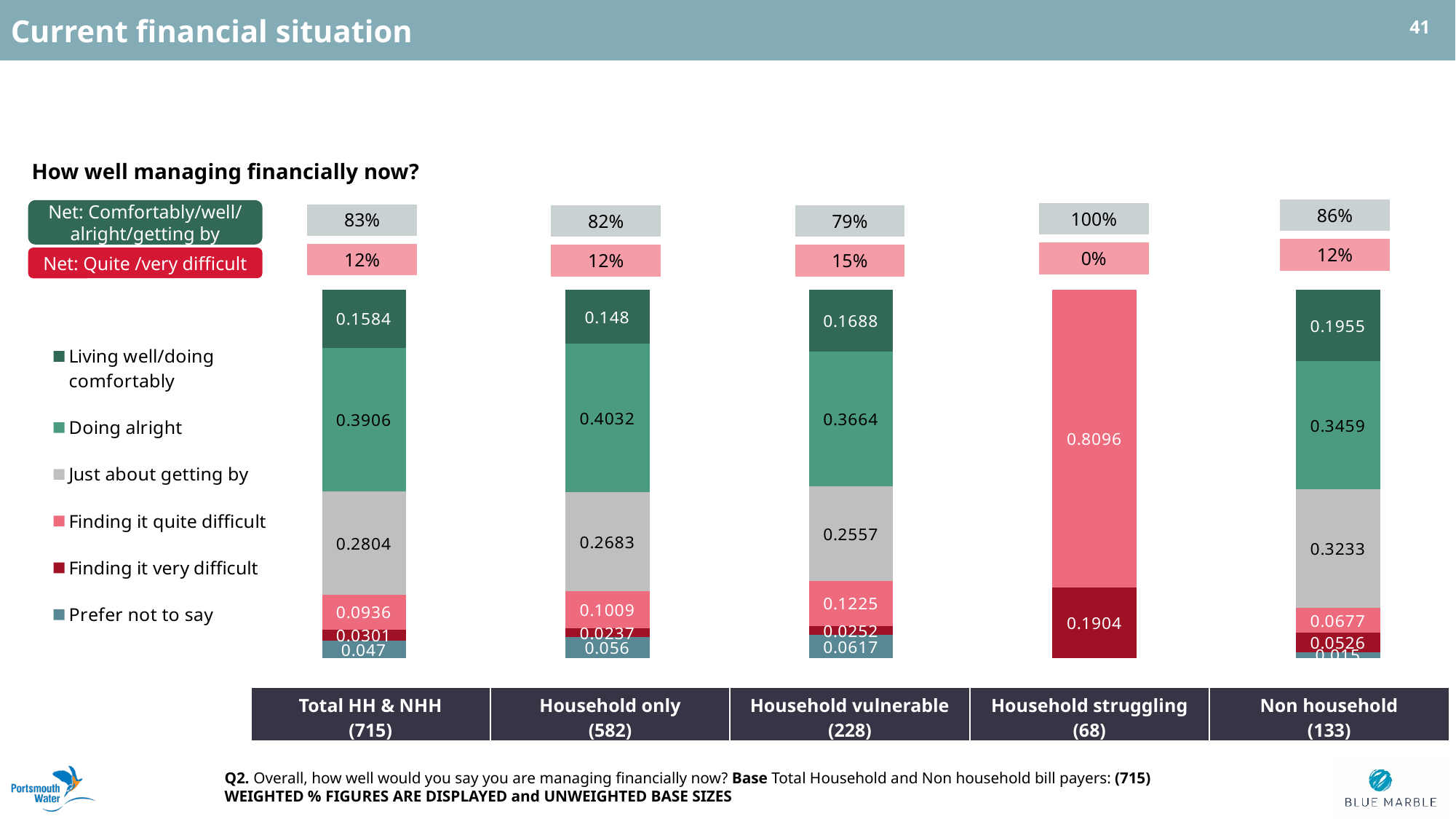
What is the value for Living well/doing comfortably in the Non household (133) bar? 0.1955 What is the Net: Comfortably/well/alright/getting by figure shown for Household struggling (68)? 100% What kind of chart is shown on the slide? Stacked bar chart How many categories (bars) are shown in the chart? 5 What is the value for Finding it quite difficult in the Household struggling (68) bar? 0.8096 How many series does the legend list? 6 Which category has the highest value for Living well/doing comfortably? Non household (133) What is the Net: Quite/very difficult figure shown for Household vulnerable (228)? 15% Which category has the highest value for Just about getting by? Non household (133) Which is larger for Finding it quite difficult: Household vulnerable (228) or Total HH & NHH (715)? Household vulnerable (228) What is the difference between the Doing alright values for Household only (582) and Household vulnerable (228)? 0.0368 What is the value for Doing alright in the Household only (582) bar? 0.4032